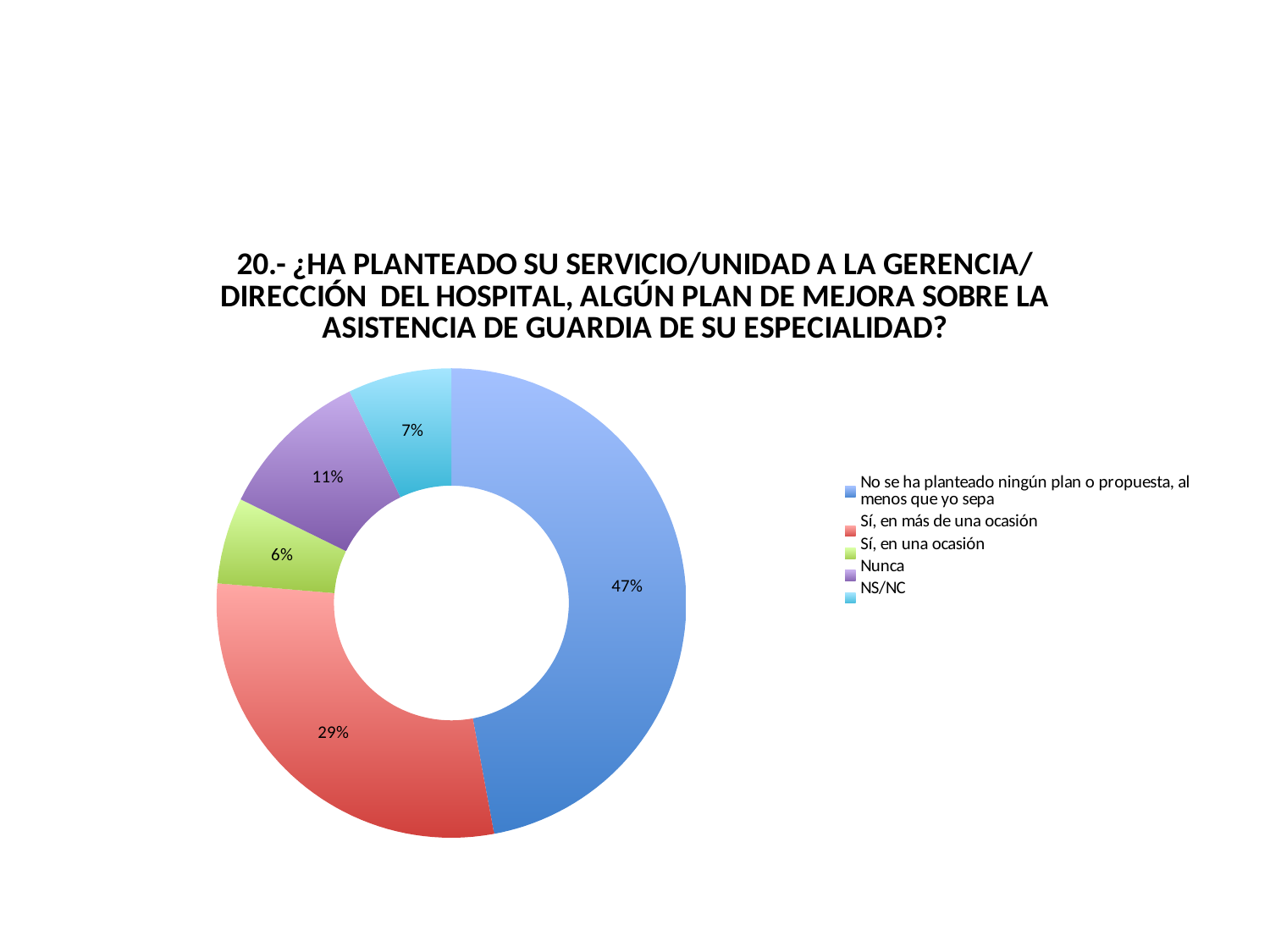
What is the difference in percentage points between "No se ha planteado ningún plan o propuesta, al menos que yo sepa" and "Sí, en más de una ocasión"? 18 Which category has the largest share of the chart? No se ha planteado ningún plan o propuesta, al menos que yo sepa What percentage of the chart corresponds to "No se ha planteado ningún plan o propuesta, al menos que yo sepa"? 47% What colour is the slice for "Sí, en una ocasión"? Green What percentage is shown for "Sí, en una ocasión"? 6% How many categories does the chart show? 5 What percentage is shown for "NS/NC"? 7% What percentage is shown for "Nunca"? 11% What type of chart is shown on the slide? Doughnut (pie) chart Which category has the smallest share of the chart? Sí, en una ocasión What percentage is shown for "Sí, en más de una ocasión"? 29% Which is larger, the share for "Nunca" or the share for "NS/NC"? Nunca